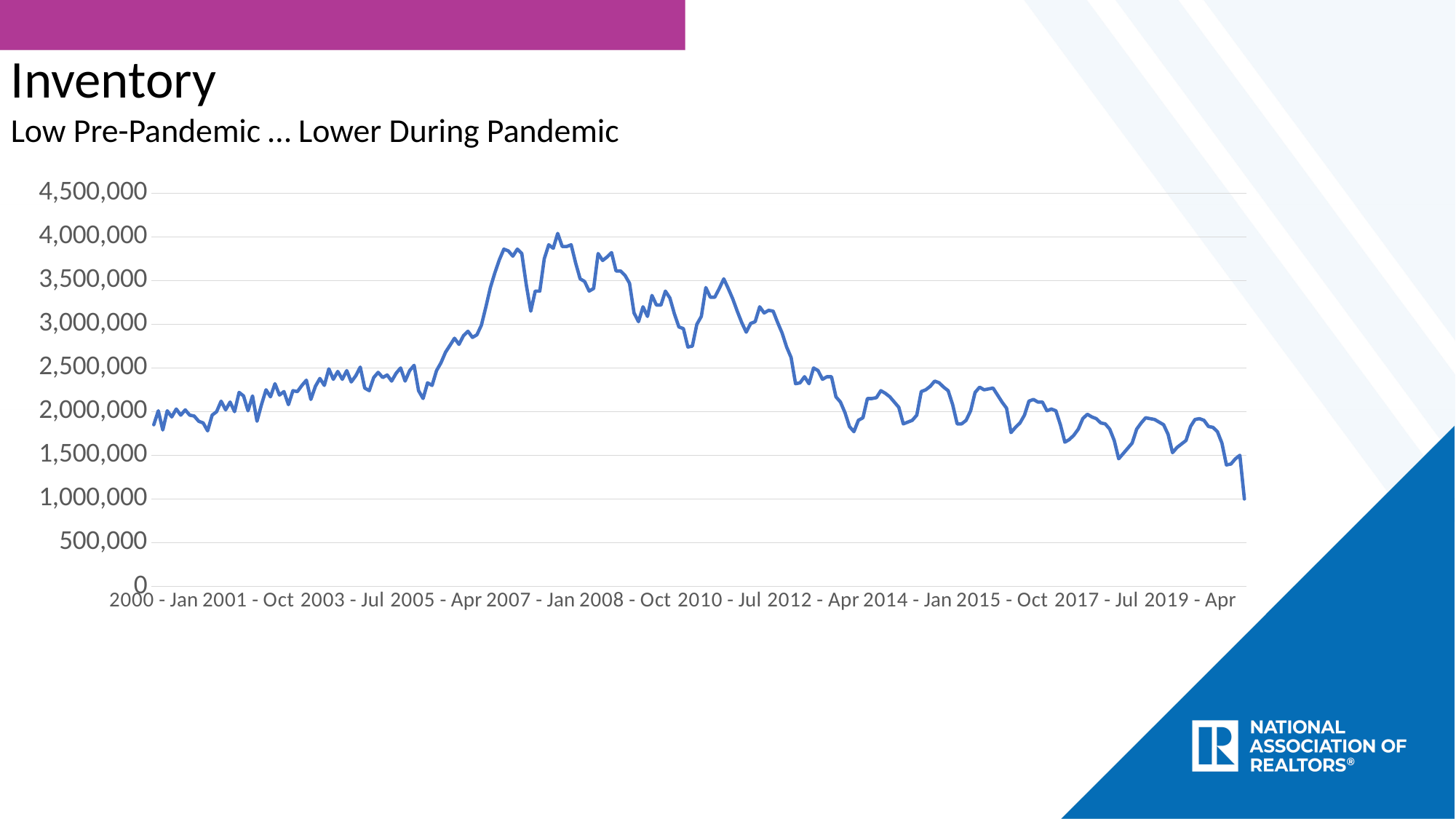
What is the title of the slide's chart? Inventory Is the value at 2019 - Apr greater or less than 2,000,000? less Is the final point on the line greater or less than 1,500,000? less What kind of chart is shown on the slide? line chart Does the line generally rise or fall between 2012 - Apr and 2019 - Apr? fall What subtitle appears under the chart title? Low Pre-Pandemic … Lower During Pandemic Is the value at 2014 - Jan greater or less than 2,500,000? less How many lines (series) are plotted on the chart? 1